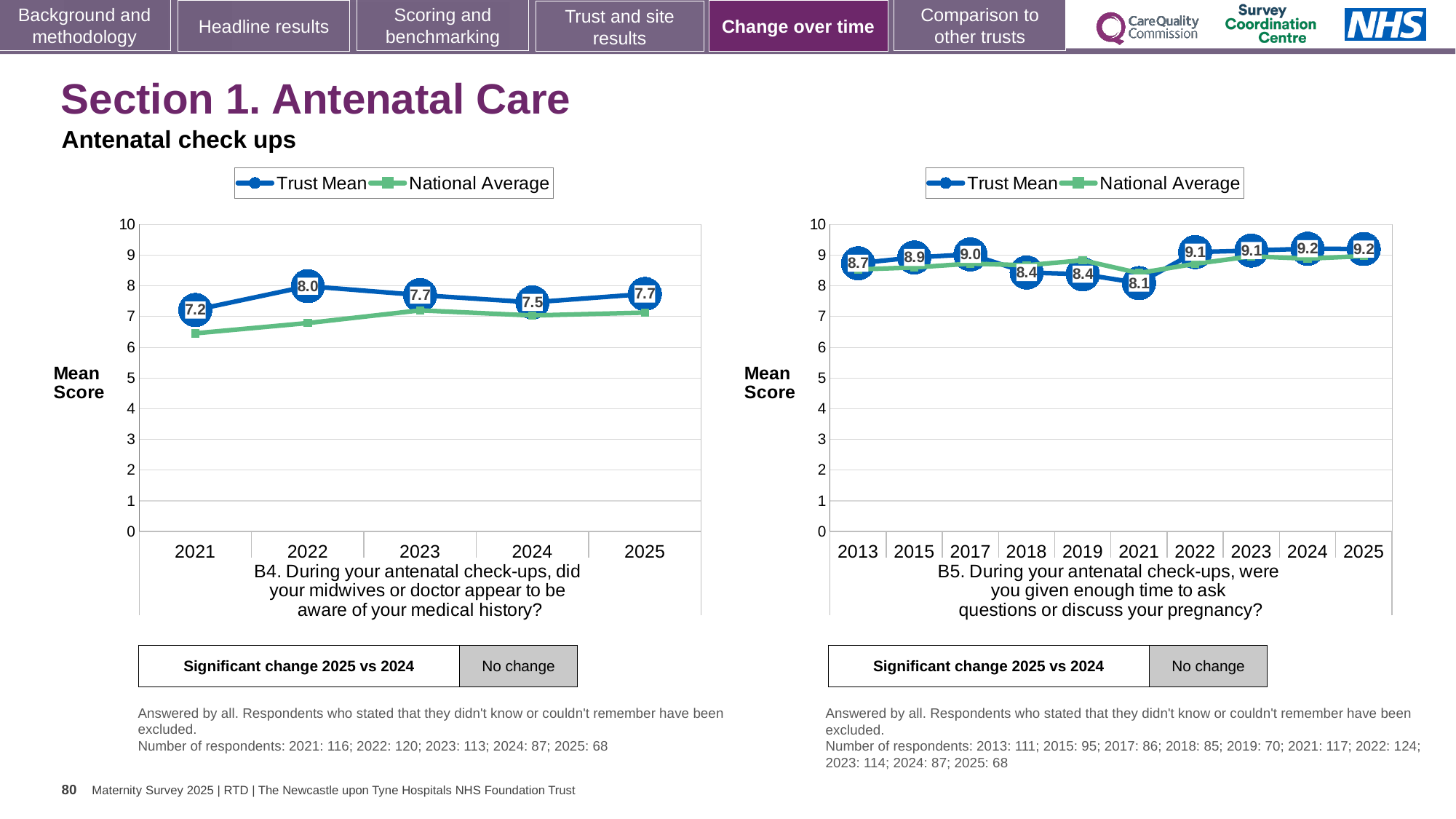
In the right chart (B5), what is the Trust Mean score for 2017? 9.0 In the left chart (B4), which year has the lowest Trust Mean score? 2021 In the left chart (B4), what is the difference between the Trust Mean scores for 2022 and 2021? 0.8 In the left chart (B4), what is the Trust Mean score for 2022? 8.0 In the left chart (B4), which year has the highest Trust Mean score? 2022 In the left chart (B4), what is the Trust Mean score for 2021? 7.2 In the left chart (B4), how many years are shown on the x axis? 5 In the right chart (B5), which year has the lowest Trust Mean score? 2021 In the right chart (B5), is the National Average for 2013 greater or less than 9? less How many series does the legend of the left chart (B4) list? 2 In the right chart (B5), how many years are shown on the x axis? 10 In the right chart (B5), what is the Trust Mean score for 2021? 8.1